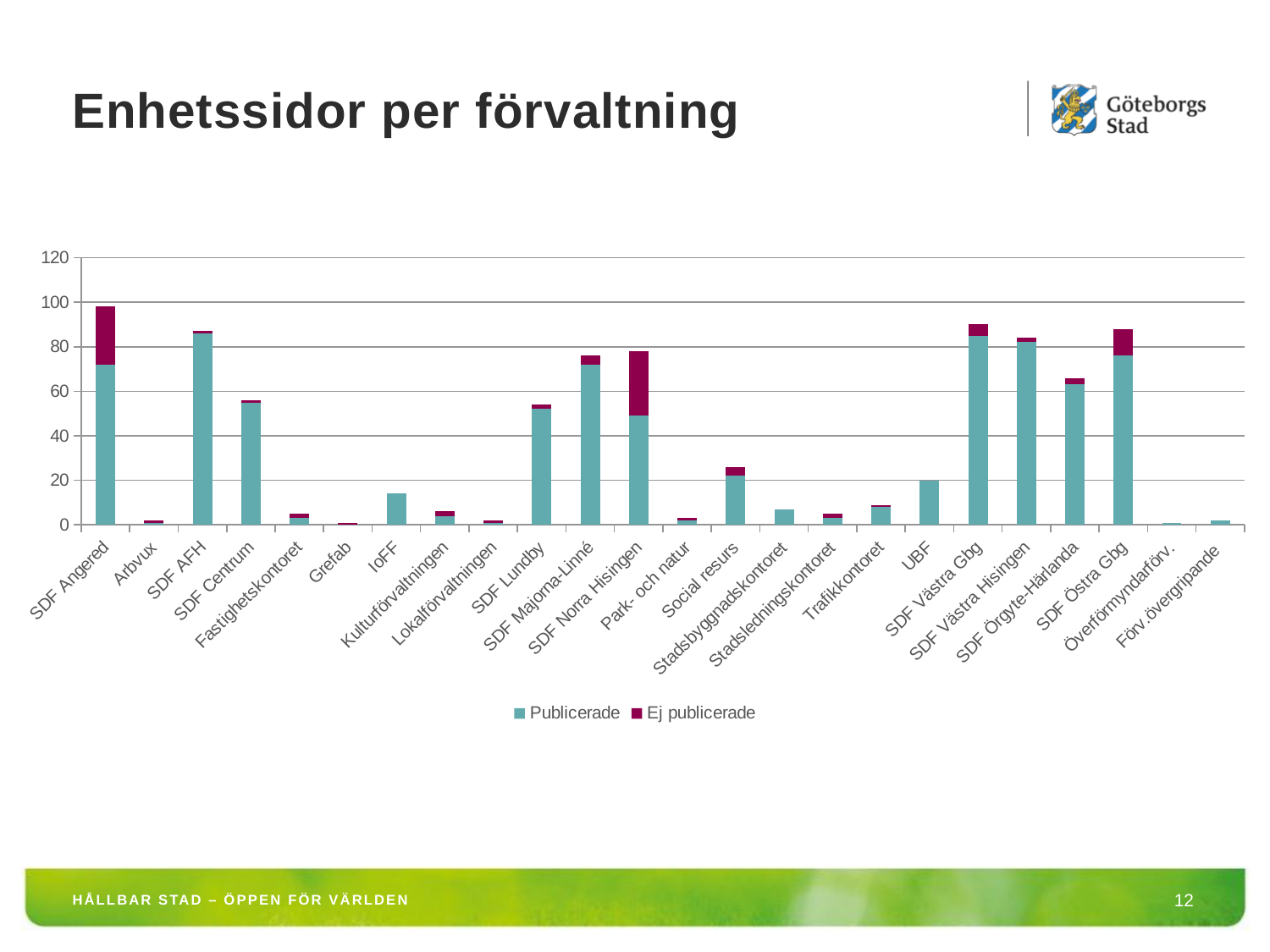
What is the title of the chart on the slide? Enhetssidor per förvaltning How many förvaltningar (categories) are shown on the x axis? 24 What are the two series named in the legend? Publicerade and Ej publicerade Which has a larger total bar, SDF AFH or SDF Centrum? SDF AFH Is the total value for SDF AFH greater or less than 80? greater Is the total value for SDF Norra Hisingen greater or less than 60? greater What kind of chart is shown on the slide? Stacked bar chart How many series does the legend list? 2 Which förvaltning has the highest total bar? SDF Angered Is the total value for IoFF greater or less than 20? less